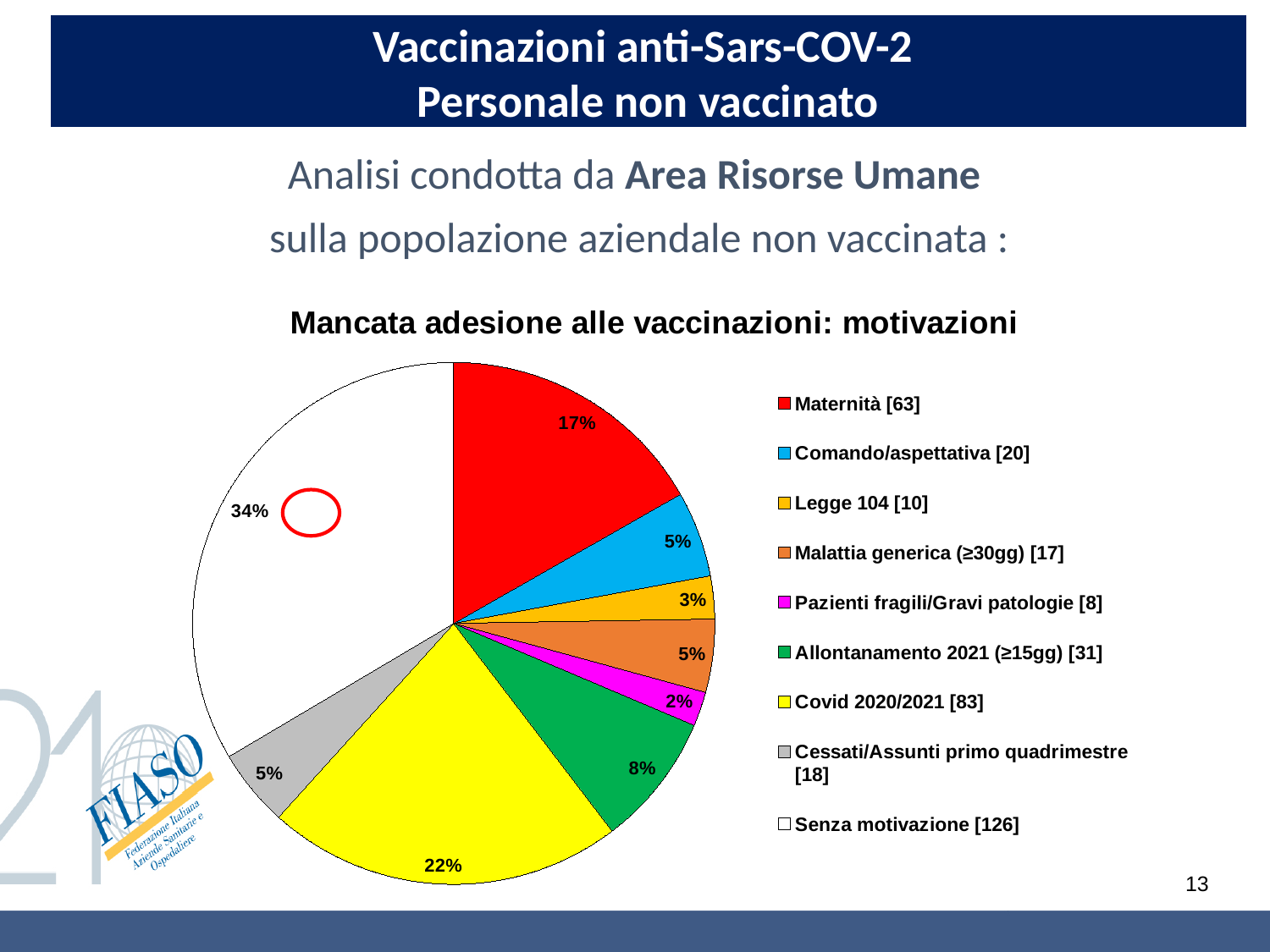
What is the difference in percentage points between the Covid 2020/2021 slice and the Maternità slice? 5 What share of the pie does Maternità represent? 17% Which category has the largest slice of the pie? Senza motivazione How many categories does the legend of the pie chart list? 9 What share of the pie does Senza motivazione represent? 34% What kind of chart is shown on the slide? pie chart What count is shown in the legend for Senza motivazione? 126 Which slice is larger, Allontanamento 2021 (≥15gg) or Legge 104? Allontanamento 2021 (≥15gg) Which category has the smallest slice of the pie? Pazienti fragili/Gravi patologie What share of the pie does Covid 2020/2021 represent? 22% What is the title of the chart? Mancata adesione alle vaccinazioni: motivazioni